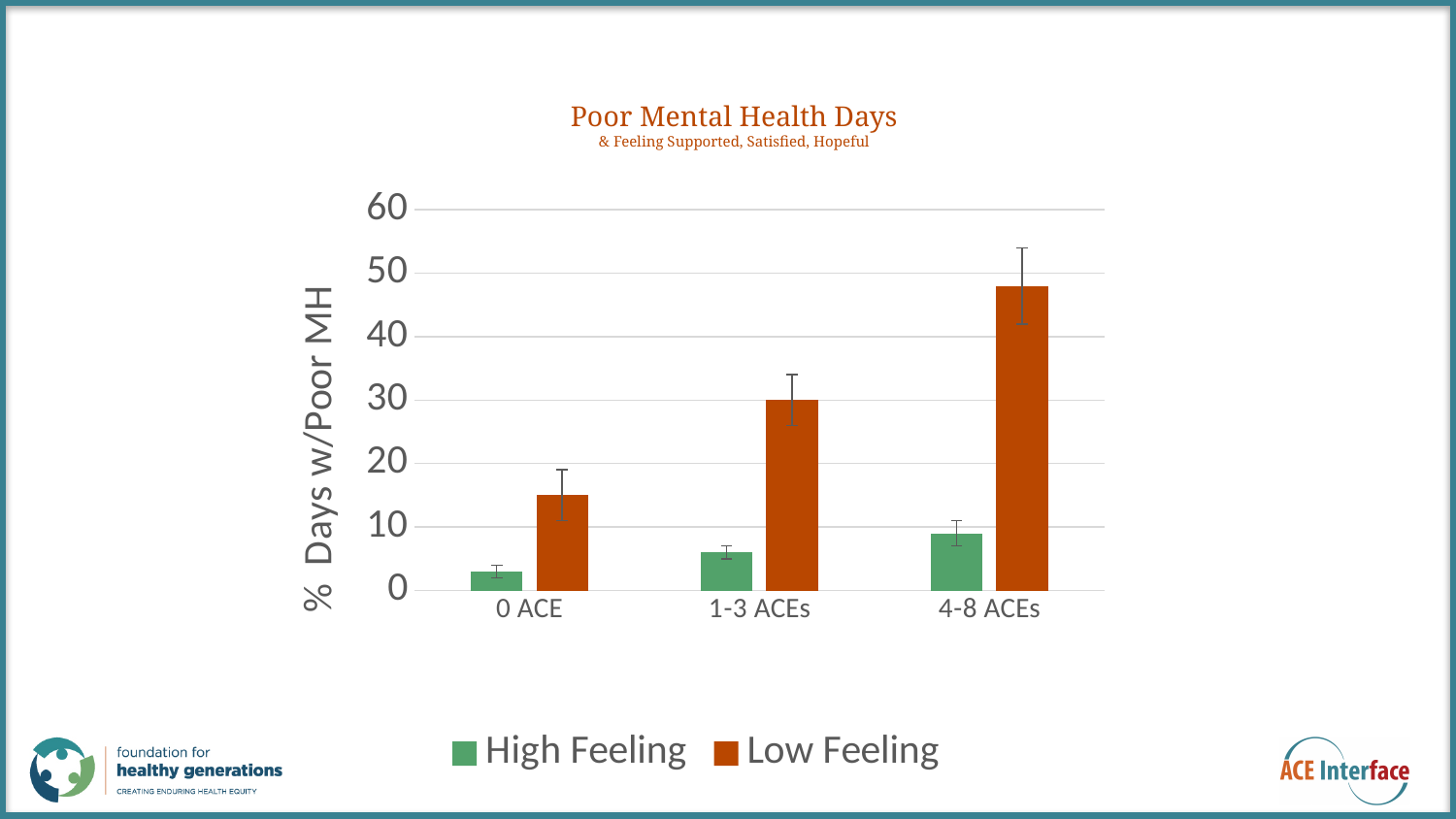
Is the Low Feeling value for 1-3 ACEs greater or less than 20? greater Which category has the highest Low Feeling value? 4-8 ACEs How many series does the legend list? 2 Which category has the lowest High Feeling value? 0 ACE Is the High Feeling value for 4-8 ACEs greater or less than 10? less Is the Low Feeling value for 4-8 ACEs greater or less than 40? greater For 1-3 ACEs, which series has the larger value, High Feeling or Low Feeling? Low Feeling What kind of chart is shown on the slide? bar chart How many ACE categories are shown on the x axis? 3 What is the title of the chart? Poor Mental Health Days Do the Low Feeling values rise or fall as the number of ACEs increases along the x axis? rise